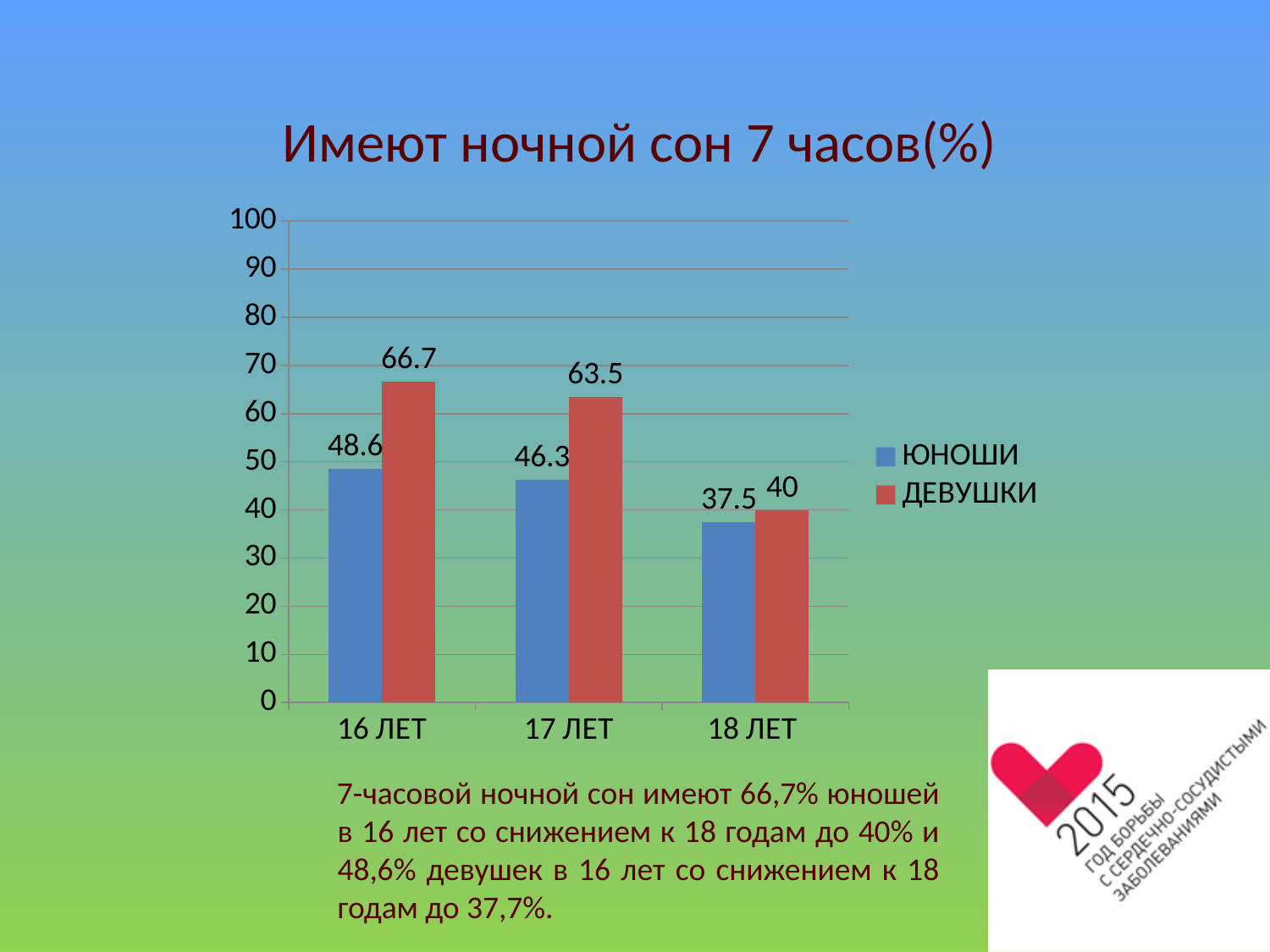
Which age category has the lowest value for ЮНОШИ? 18 ЛЕТ Which age category has the highest value for ДЕВУШКИ? 16 ЛЕТ What is the value for ЮНОШИ at 16 ЛЕТ? 48.6 How many series does the legend list? 2 What kind of chart is shown on the slide? bar chart At 17 ЛЕТ, which series has the larger value, ЮНОШИ or ДЕВУШКИ? ДЕВУШКИ What is the value for ЮНОШИ at 18 ЛЕТ? 37.5 How many age categories are shown on the x axis? 3 What is the difference between the ДЕВУШКИ and ЮНОШИ values at 16 ЛЕТ? 18.1 What is the value for ДЕВУШКИ at 18 ЛЕТ? 40 What is the value for ДЕВУШКИ at 17 ЛЕТ? 63.5 Do the ЮНОШИ values rise or fall from 16 ЛЕТ to 18 ЛЕТ? fall